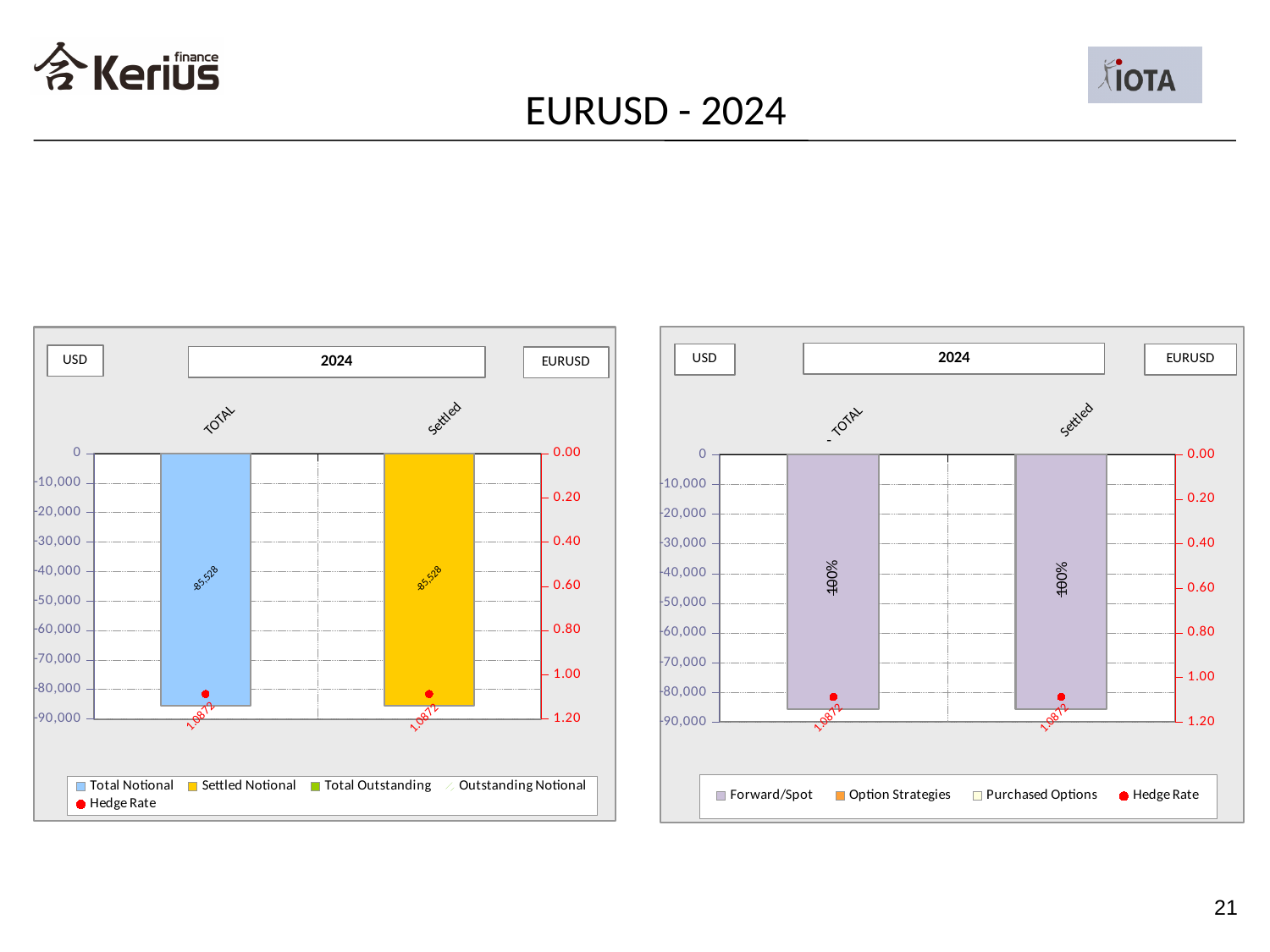
How many series does the legend of the left chart list? 5 On the left chart, what is the data label on the Settled bar? -85,528 On the left chart, what is the data label on the TOTAL bar? -85,528 How many categories are shown on the x axis of the left chart? 2 On the right chart, what Hedge Rate value is labelled for Settled? 1.0872 On the right chart, what percentage label is shown on the Settled bar? 100% On the left chart, what Hedge Rate value is labelled for TOTAL? 1.0872 How many series does the legend of the right chart list? 4 What kind of chart is the left chart? Bar chart On the left chart, what is the difference between the TOTAL and Settled bar values? 0 On the right chart, what percentage label is shown on the TOTAL bar? 100% On the right chart, which legend entry corresponds to the purple bars? Forward/Spot